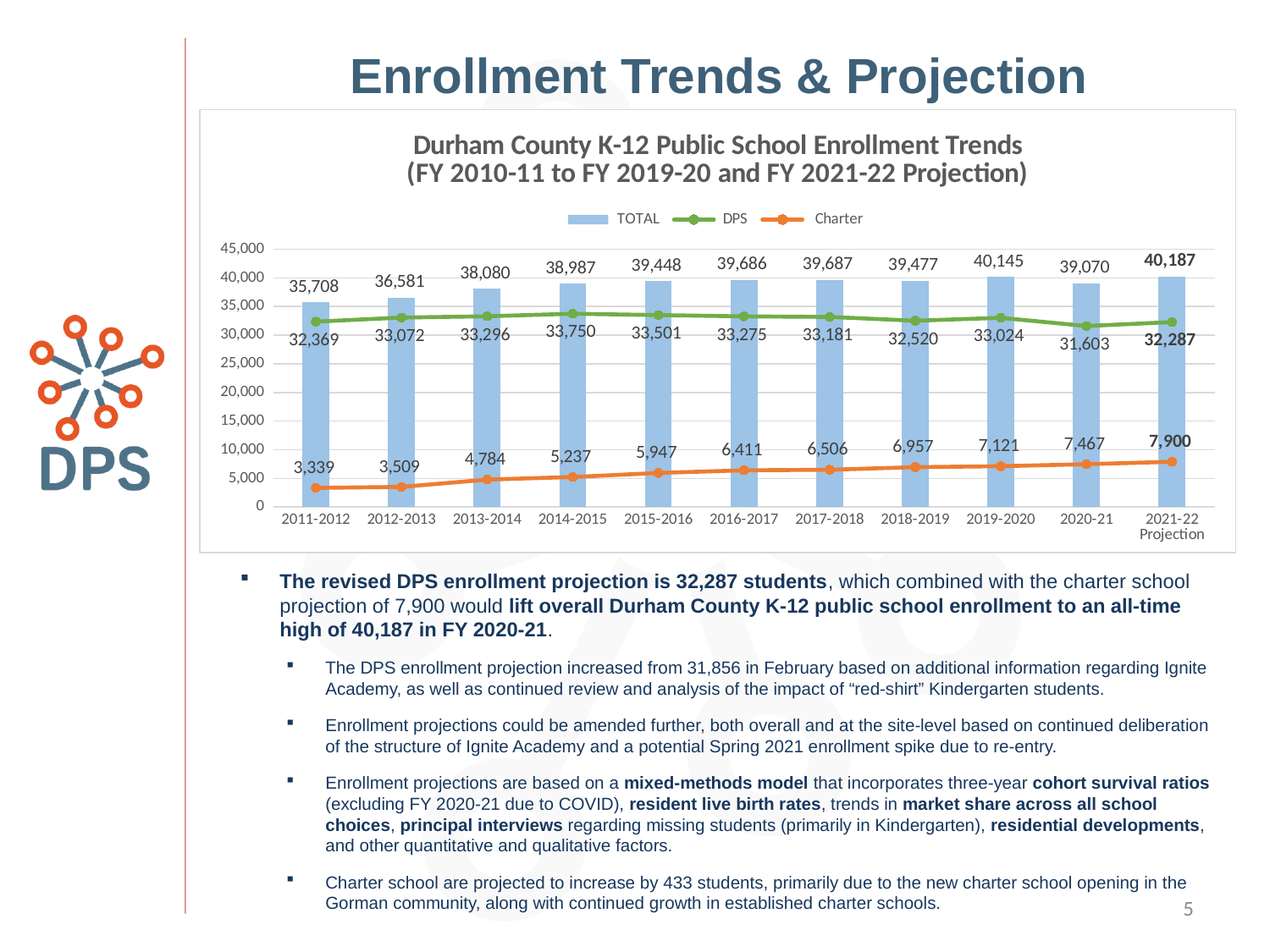
What is the TOTAL enrollment value shown for 2011-2012? 35,708 How many years (categories) are shown on the x axis? 11 Does the Charter series rise or fall from 2011-2012 to the 2021-22 Projection? rise Which is larger, the DPS value for 2012-2013 or for 2013-2014? 2013-2014 What is the Charter enrollment value shown for the 2021-22 Projection? 7,900 What is the difference between the Charter values for the 2021-22 Projection and 2020-21? 433 Which series is plotted as bars rather than a line? TOTAL How many series does the legend list? 3 What is the DPS enrollment value shown for 2020-21? 31,603 In which year does the DPS series reach its highest value? 2014-2015 In which year is the TOTAL enrollment lowest? 2011-2012 What is the difference between the DPS values for 2019-2020 and 2020-21? 1,421